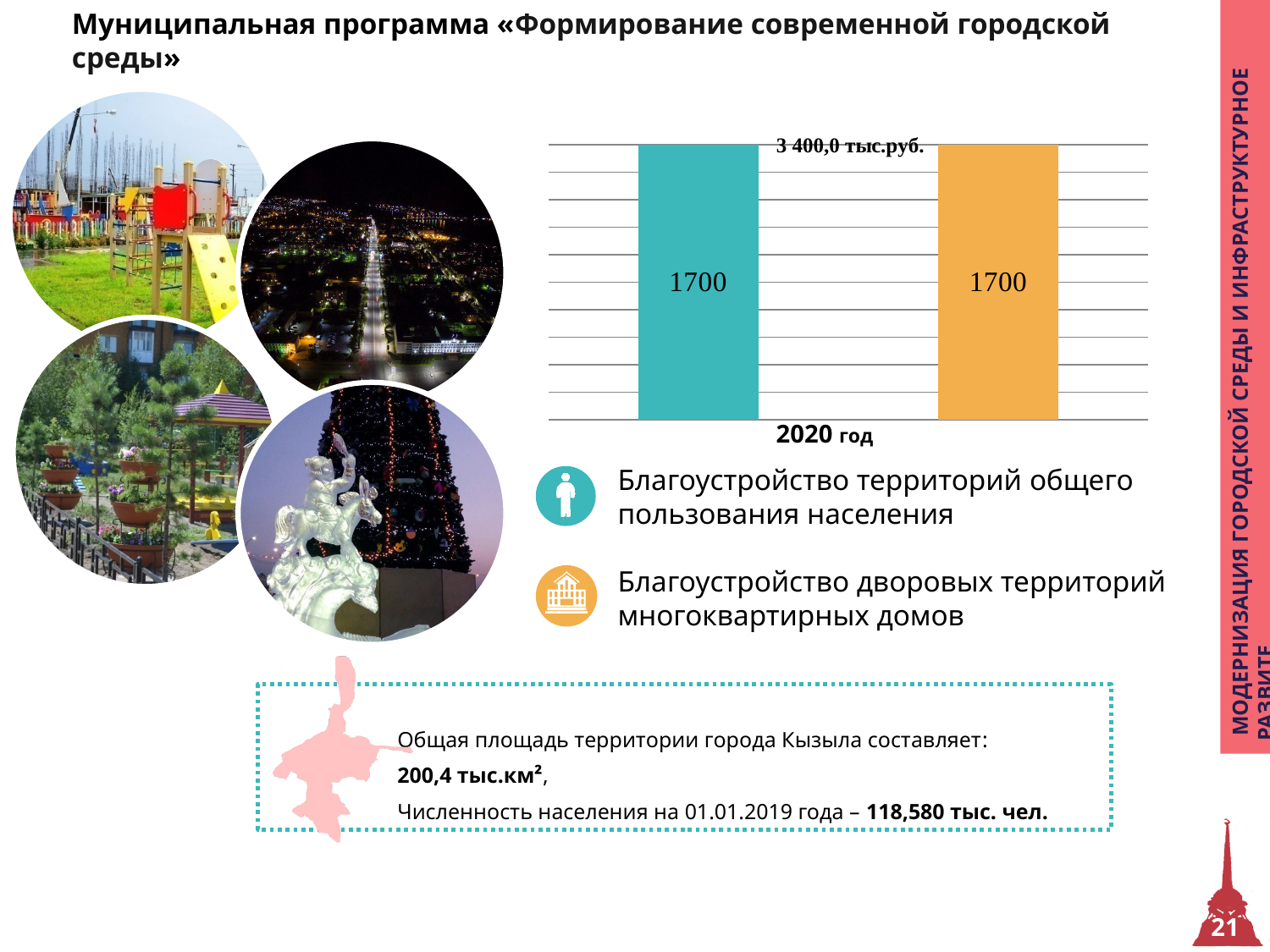
Which year is shown on the x axis of the chart? 2020 год How many bars are plotted in the chart? 2 What is the value of the orange bar for 2020 год? 1700 What is the difference between the teal bar and the orange bar? 0 Is the value of the teal bar greater or less than 1000? greater What is the value of the teal bar for 2020 год? 1700 What is the combined total of the two bars in the chart? 3400 What type of chart is shown on the slide? bar chart What is the value for «Благоустройство территорий общего пользования населения» in 2020 год? 1700 What is the value for «Благоустройство дворовых территорий многоквартирных домов» in 2020 год? 1700 What total amount is printed at the top of the chart? 3 400,0 тыс.руб.